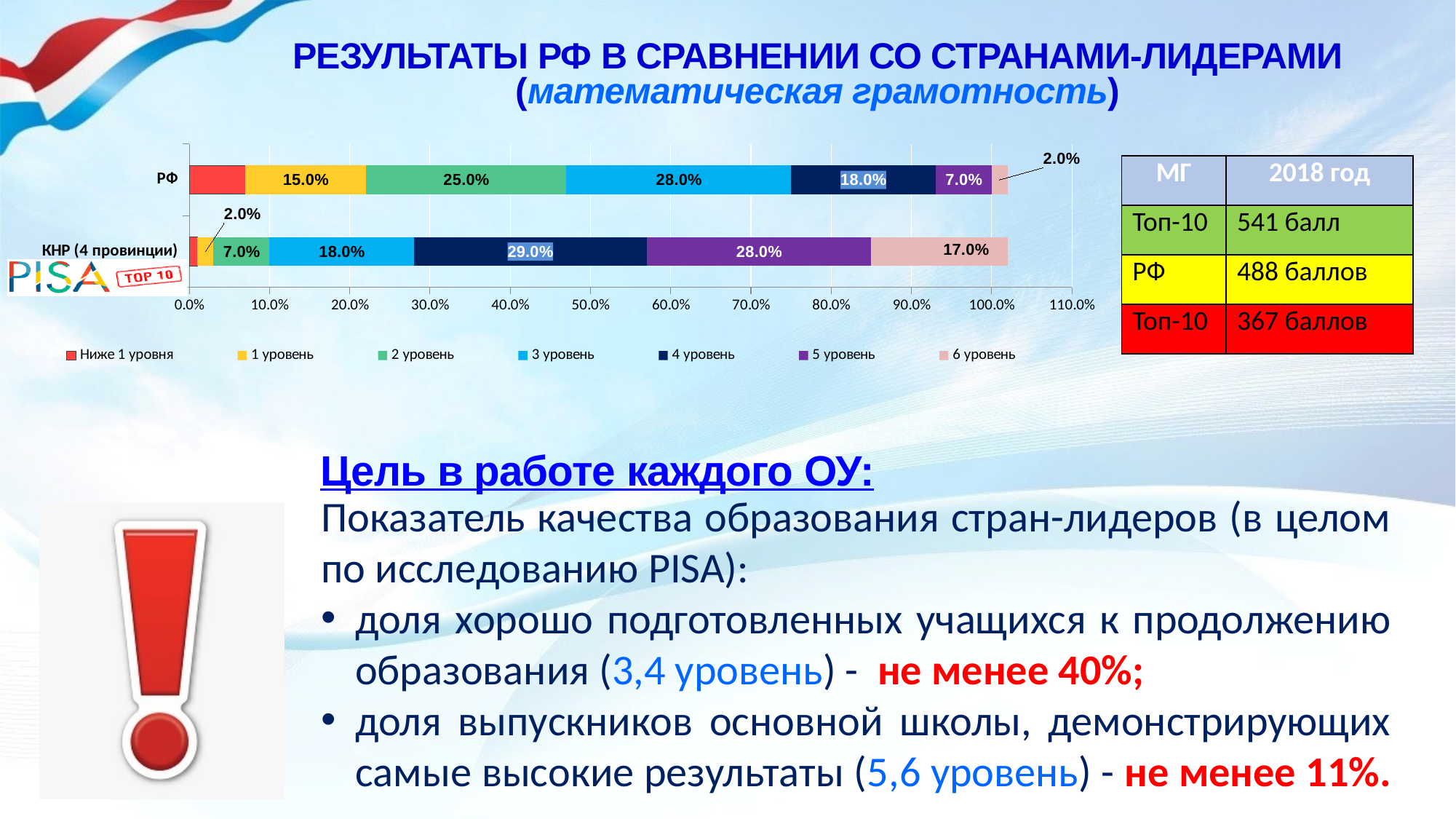
What is the difference between 6 уровень for КНР (4 провинции) and 6 уровень for РФ? 15.0% What is the combined share of 3 уровень and 4 уровень for РФ? 46.0% Which level has the largest share in the РФ bar? 3 уровень Is the value of Ниже 1 уровня for РФ greater or less than 10.0%? less How many series does the chart legend list? 7 What is the value of 6 уровень for РФ? 2.0% What is the value of 3 уровень for РФ? 28.0% How many categories (bars) are plotted in the chart? 2 What is the value of 1 уровень for КНР (4 провинции)? 2.0% What is the value of 4 уровень for КНР (4 провинции)? 29.0% What type of chart is shown on the slide? stacked bar chart Which is larger: 5 уровень for РФ or 5 уровень for КНР (4 провинции)? КНР (4 провинции)